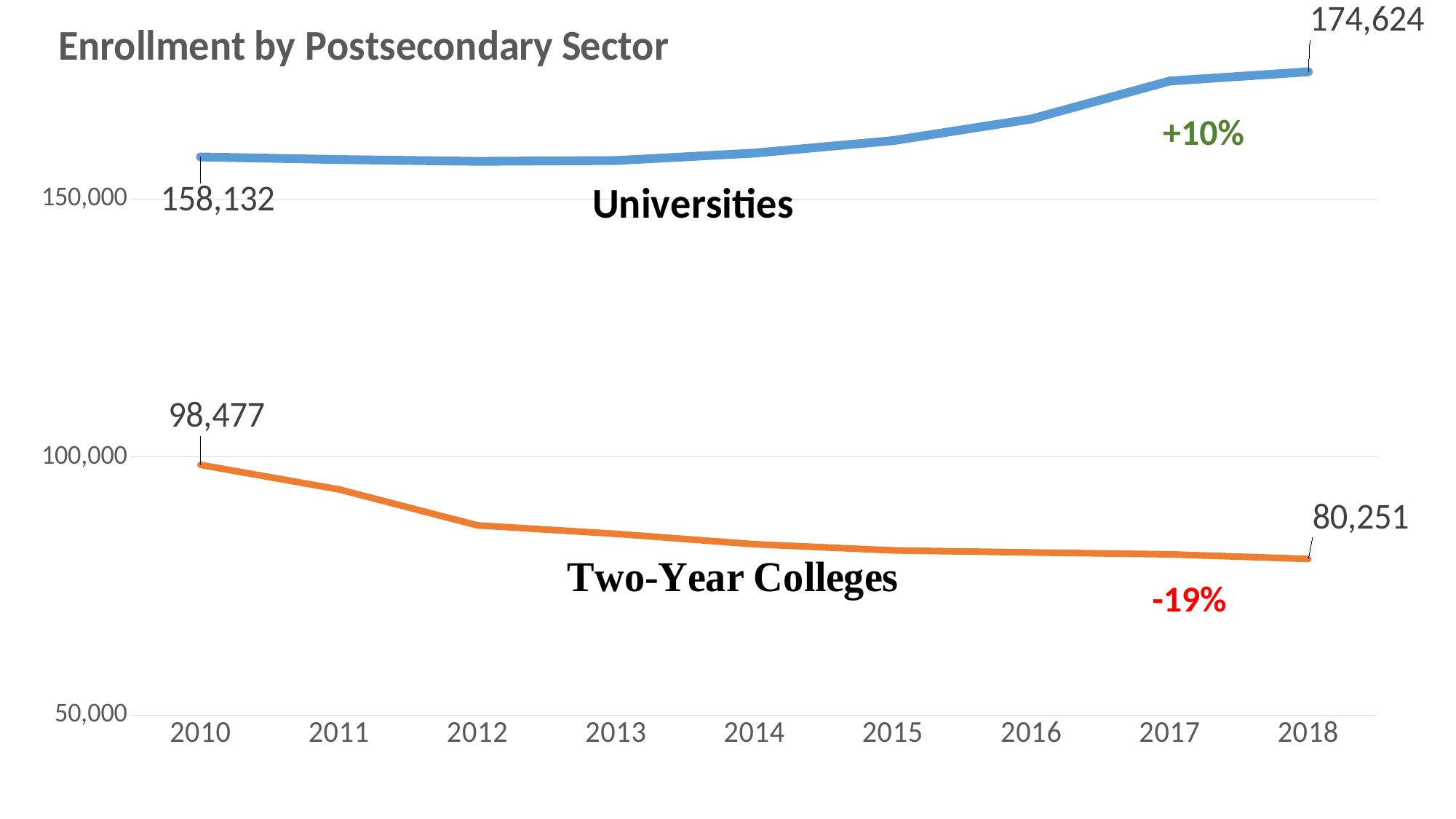
What was university enrollment in 2010? 158,132 What percentage change is shown for Two-Year Colleges? -19% What percentage change is shown for Universities? +10% What kind of chart is shown on the slide? line chart What is the title of the chart? Enrollment by Postsecondary Sector By how much did two-year college enrollment fall from 2010 to 2018? 18,226 Does two-year college enrollment rise or fall from 2010 to 2018? fall How many years are shown on the x axis? 9 What was two-year college enrollment in 2010? 98,477 What was two-year college enrollment in 2018? 80,251 What was university enrollment in 2018? 174,624 By how much did university enrollment change from 2010 to 2018? 16,492